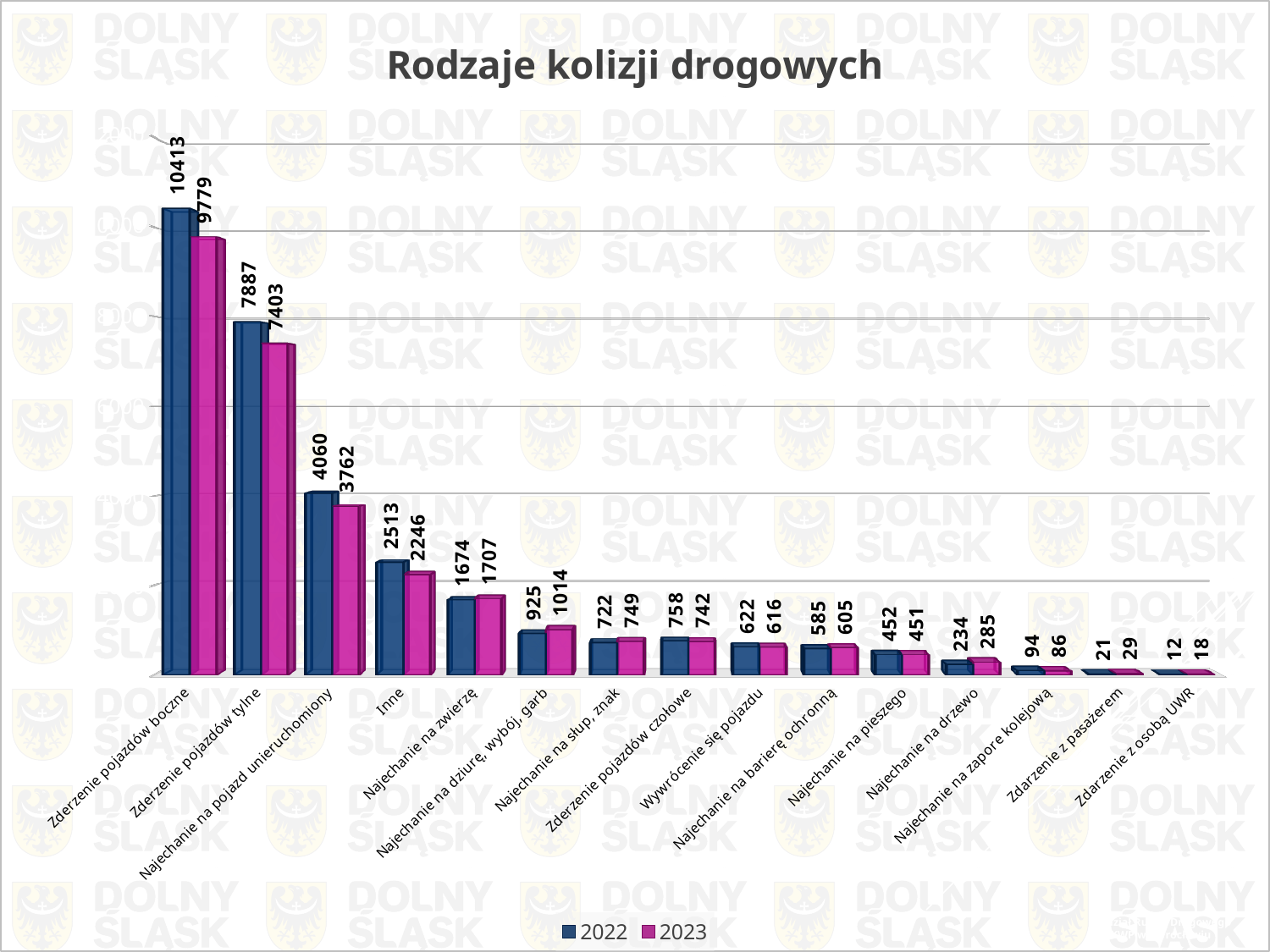
What is the difference between the 2022 and 2023 values for Zderzenie pojazdów tylne? 484 What is the 2023 value for Najechanie na drzewo? 285 What is the 2022 value for Zderzenie pojazdów boczne? 10413 How many categories are shown on the x axis? 15 Which category has the highest 2023 value? Zderzenie pojazdów boczne Which category has the lowest 2022 value? Zdarzenie z osobą UWR How many series does the legend list? 2 Which series is shown in dark blue? 2022 What type of chart is shown on the slide? bar chart What is the title of the chart? Rodzaje kolizji drogowych What is the 2023 value for Najechanie na pojazd unieruchomiony? 3762 For Najechanie na dziurę, wybój, garb, which year has the larger value, 2022 or 2023? 2023